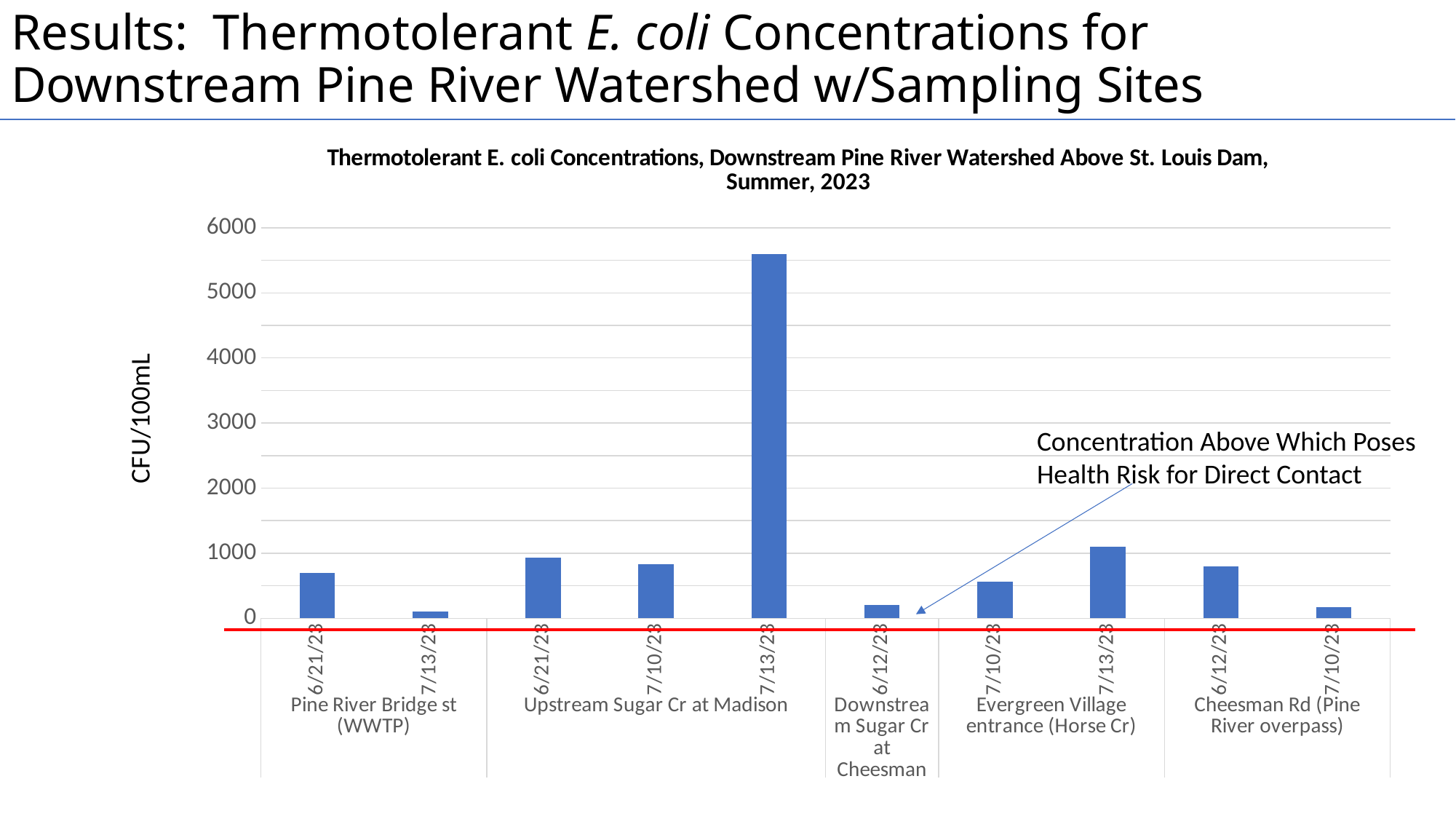
Which sampling site and date has the highest E. coli concentration? Upstream Sugar Cr at Madison, 7/13/23 Is the value for Evergreen Village entrance (Horse Cr) on 7/13/23 greater or less than 1000? greater How many bars are plotted in the chart? 10 Is the value for Upstream Sugar Cr at Madison on 7/13/23 greater or less than 5000? greater At Evergreen Village entrance (Horse Cr), which date has the larger value, 7/10/23 or 7/13/23? 7/13/23 What does the red horizontal line on the chart represent? Concentration Above Which Poses Health Risk for Direct Contact Is the value for Downstream Sugar Cr at Cheesman on 6/12/23 greater or less than 1000? less At Cheesman Rd (Pine River overpass), which date has the larger value, 6/12/23 or 7/10/23? 6/12/23 What is the label on the y axis of the chart? CFU/100mL How many sampling sites are labelled along the x axis? 5 What kind of chart is shown on the slide? bar chart